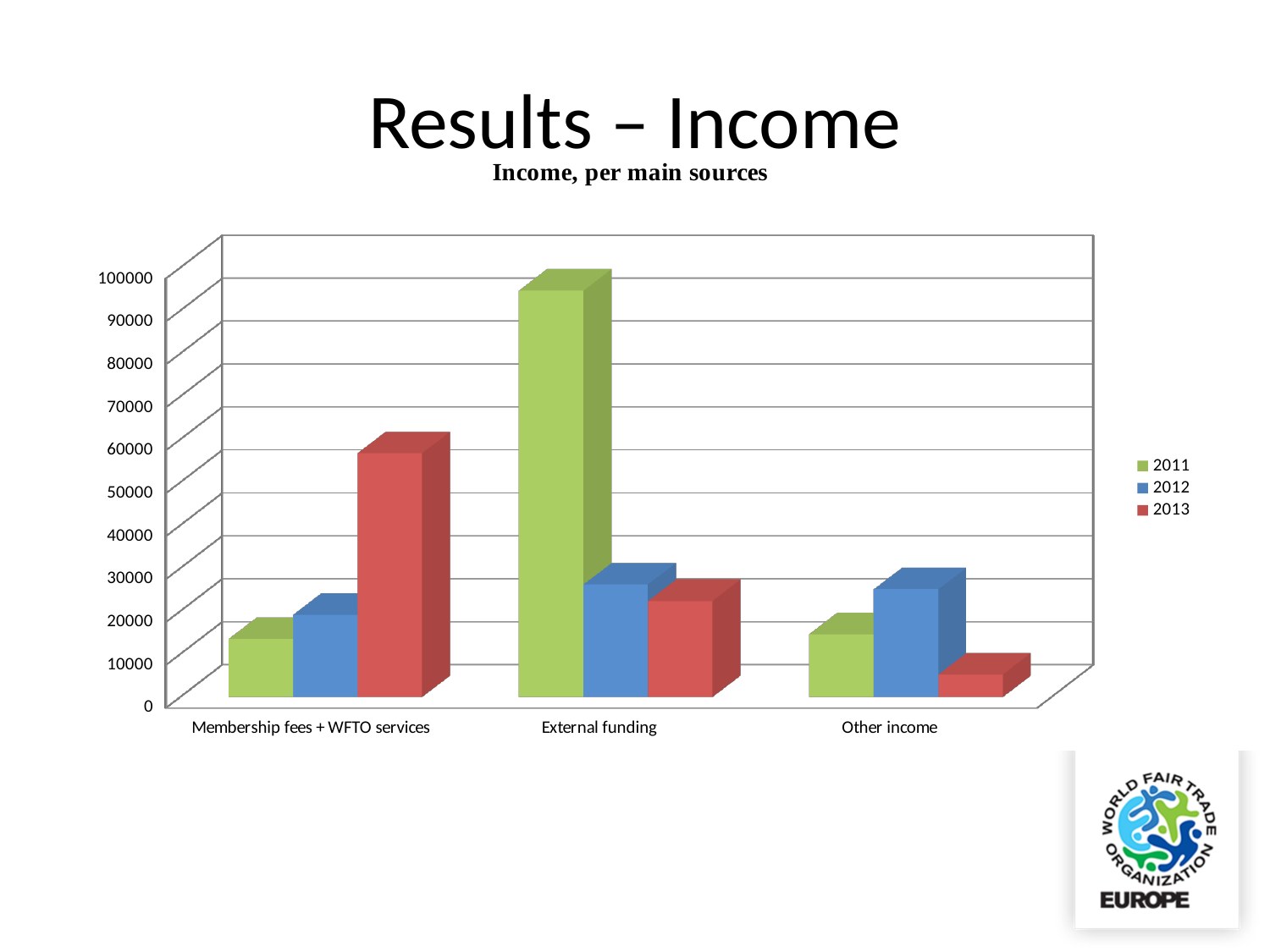
Which year has the lowest value for Other income? 2013 Which years are listed in the legend? 2011, 2012, 2013 Which is larger for 2013: Membership fees + WFTO services or External funding? Membership fees + WFTO services What kind of chart is shown on the slide? bar chart How many income source categories are shown on the x axis? 3 Which category has the tallest bar in the chart? External funding What is the title of the chart? Income, per main sources Do the 2013 values rise or fall moving from Membership fees + WFTO services to Other income? fall Is the 2013 value for Membership fees + WFTO services greater or less than 50000? greater Is the 2011 value for External funding greater or less than 80000? greater Which year has the highest value for Membership fees + WFTO services? 2013 How many series does the legend list? 3